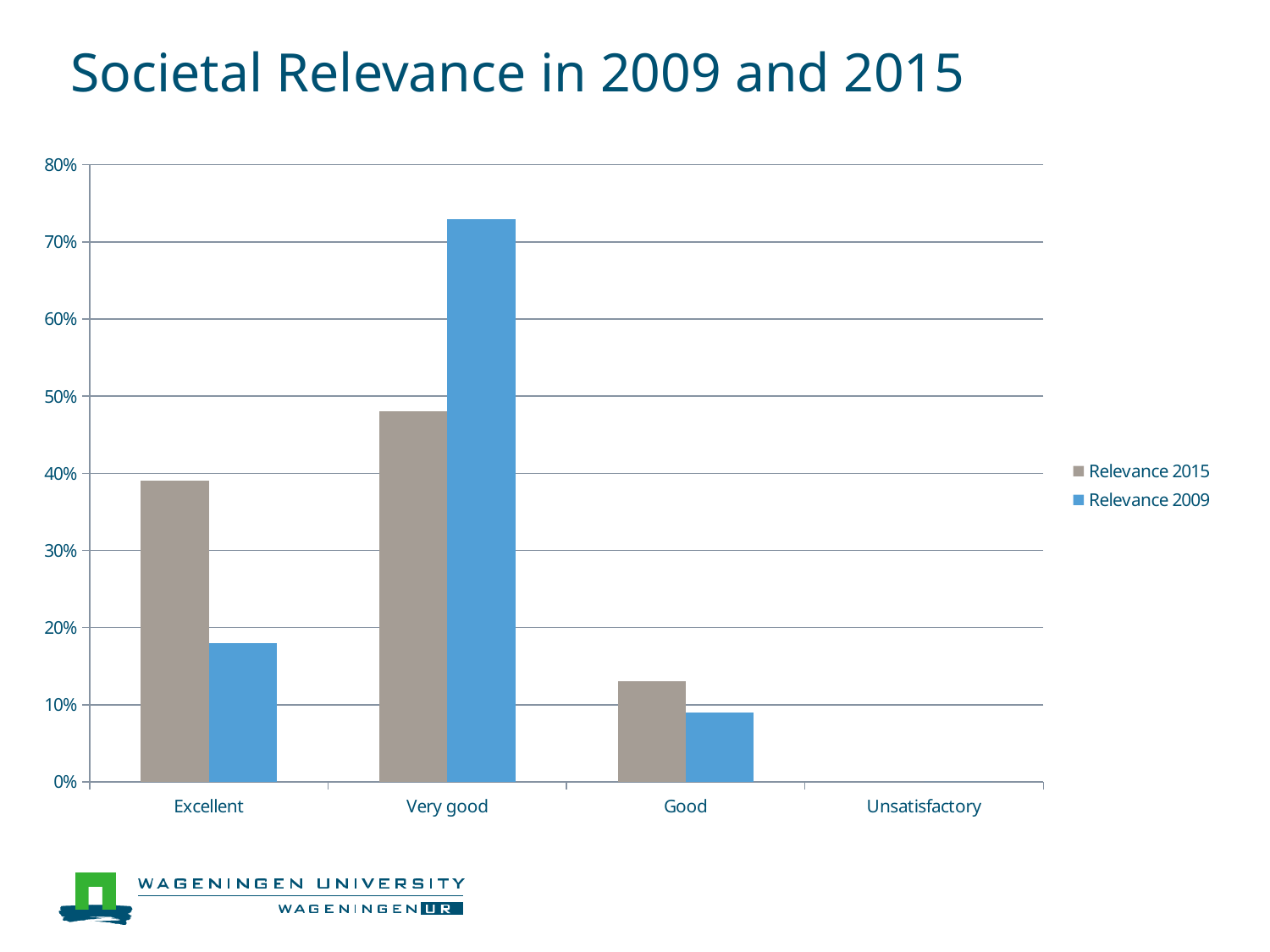
How many categories are shown on the x axis? 4 Is the value for Good in Relevance 2015 greater or less than 10%? greater Is the value for Very good in Relevance 2009 greater or less than 70%? greater For the Very good category, which series has the larger value, Relevance 2015 or Relevance 2009? Relevance 2009 Which category has the highest value for Relevance 2015? Very good What is the title of the slide? Societal Relevance in 2009 and 2015 Is the value for Excellent in Relevance 2009 greater or less than 20%? less What kind of chart is shown on the slide? bar chart Which category has the highest value for Relevance 2009? Very good How many series does the legend list? 2 For the Excellent category, which series has the larger value, Relevance 2015 or Relevance 2009? Relevance 2015